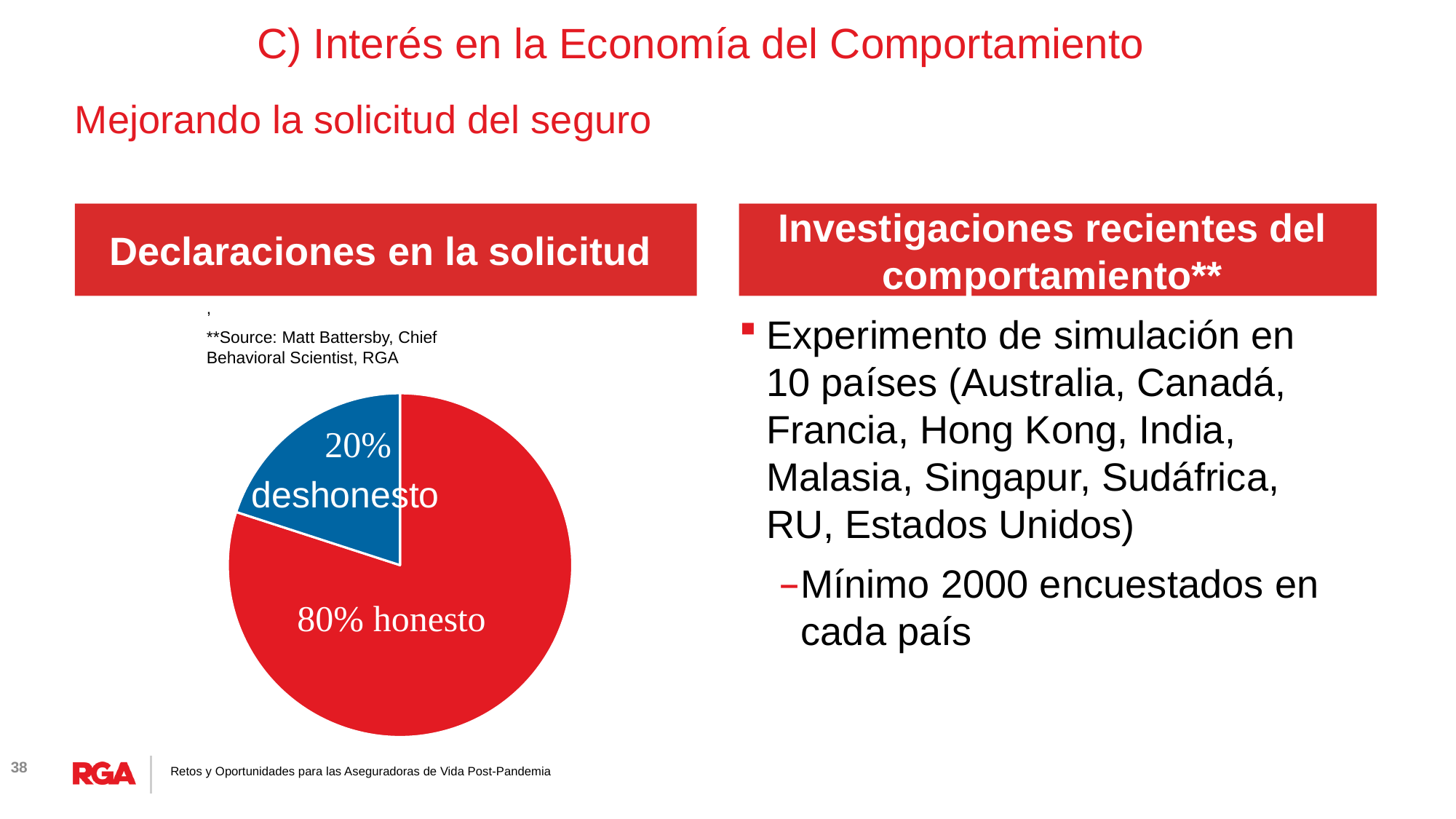
What colour is the 'deshonesto' slice of the pie chart? blue How many slices does the pie chart have? 2 What is the difference in percentage points between the 'honesto' and 'deshonesto' slices? 60 What share of the pie chart is labelled 'deshonesto'? 20% What kind of chart is shown under 'Declaraciones en la solicitud'? pie chart What colour is the 'honesto' slice of the pie chart? red What is the total of the two slices shown in the pie chart? 100% Which slice of the pie chart is the largest? honesto Which slice of the pie chart is the smallest? deshonesto What share of the pie chart is labelled 'honesto'? 80% Which slice is larger, 'honesto' or 'deshonesto'? honesto